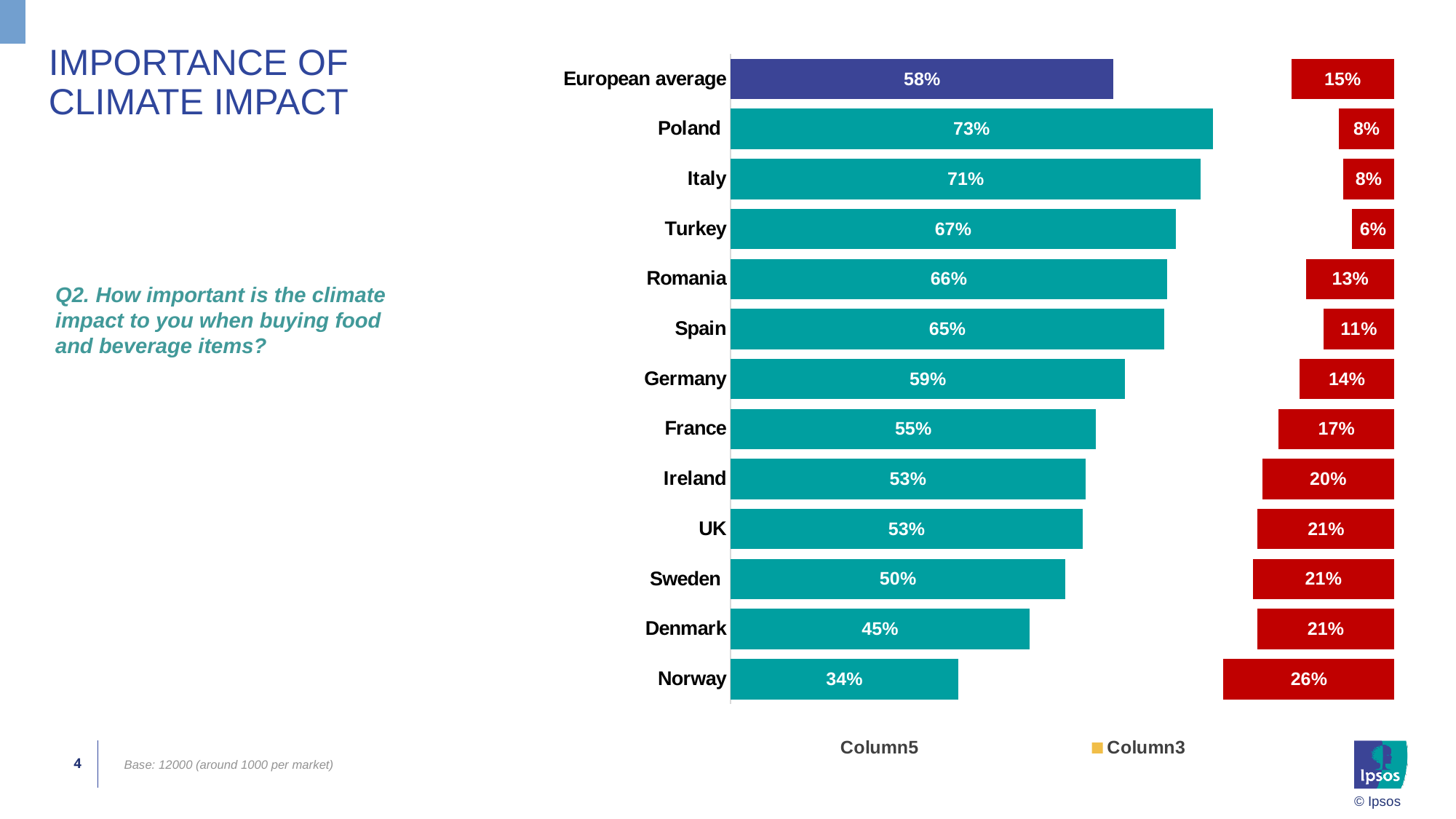
What kind of chart is shown on the slide? Bar chart Which country has the highest teal bar value? Poland What is the value of the red bar for Norway? 26% Which country has the lowest teal bar value? Norway How many series does the legend list? 2 What is the value of the teal bar for Poland? 73% What is the difference between the teal bar values for Italy and Denmark? 26% What is the value of the teal bar for the European average? 58% Which country has the highest red bar value? Norway What is the value of the red bar for Turkey? 6% How many categories are shown on the chart? 13 Which has a larger teal bar value, Germany or France? Germany